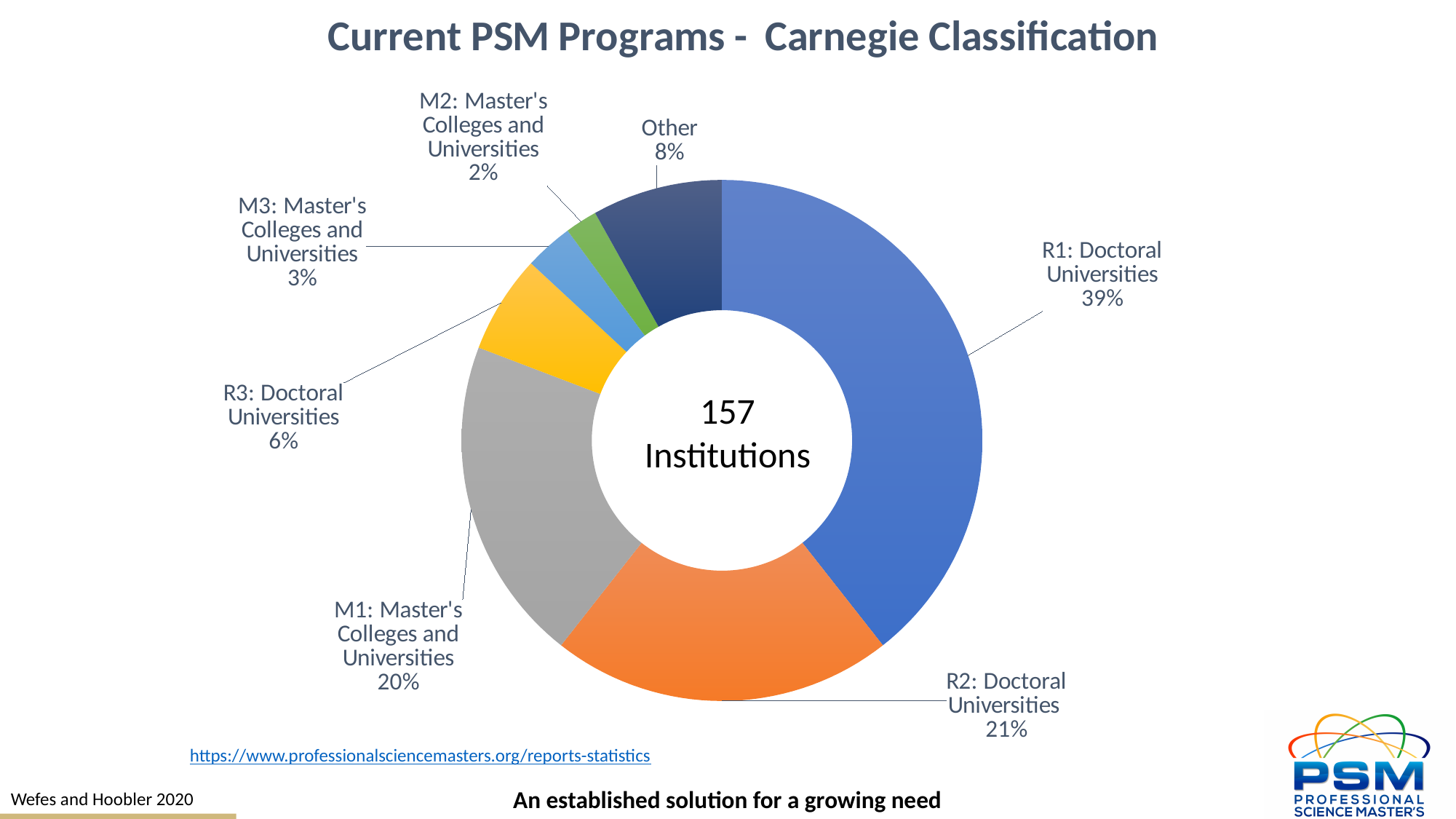
What is the title of the chart? Current PSM Programs - Carnegie Classification What number of institutions is shown in the centre of the chart? 157 Institutions What percentage is shown for M1: Master's Colleges and Universities? 20% What share of the donut chart is R1: Doctoral Universities? 39% What kind of chart is shown on the slide? Donut (pie) chart Which is larger, the share for R3: Doctoral Universities or the share for M3: Master's Colleges and Universities? R3: Doctoral Universities What percentage is shown for the Other category? 8% Which category has the smallest share of the chart? M2: Master's Colleges and Universities How many categories are shown in the chart? 7 Which category has the largest share of the chart? R1: Doctoral Universities What percentage is shown for R2: Doctoral Universities? 21% What is the difference in percentage points between R1: Doctoral Universities and R2: Doctoral Universities? 18